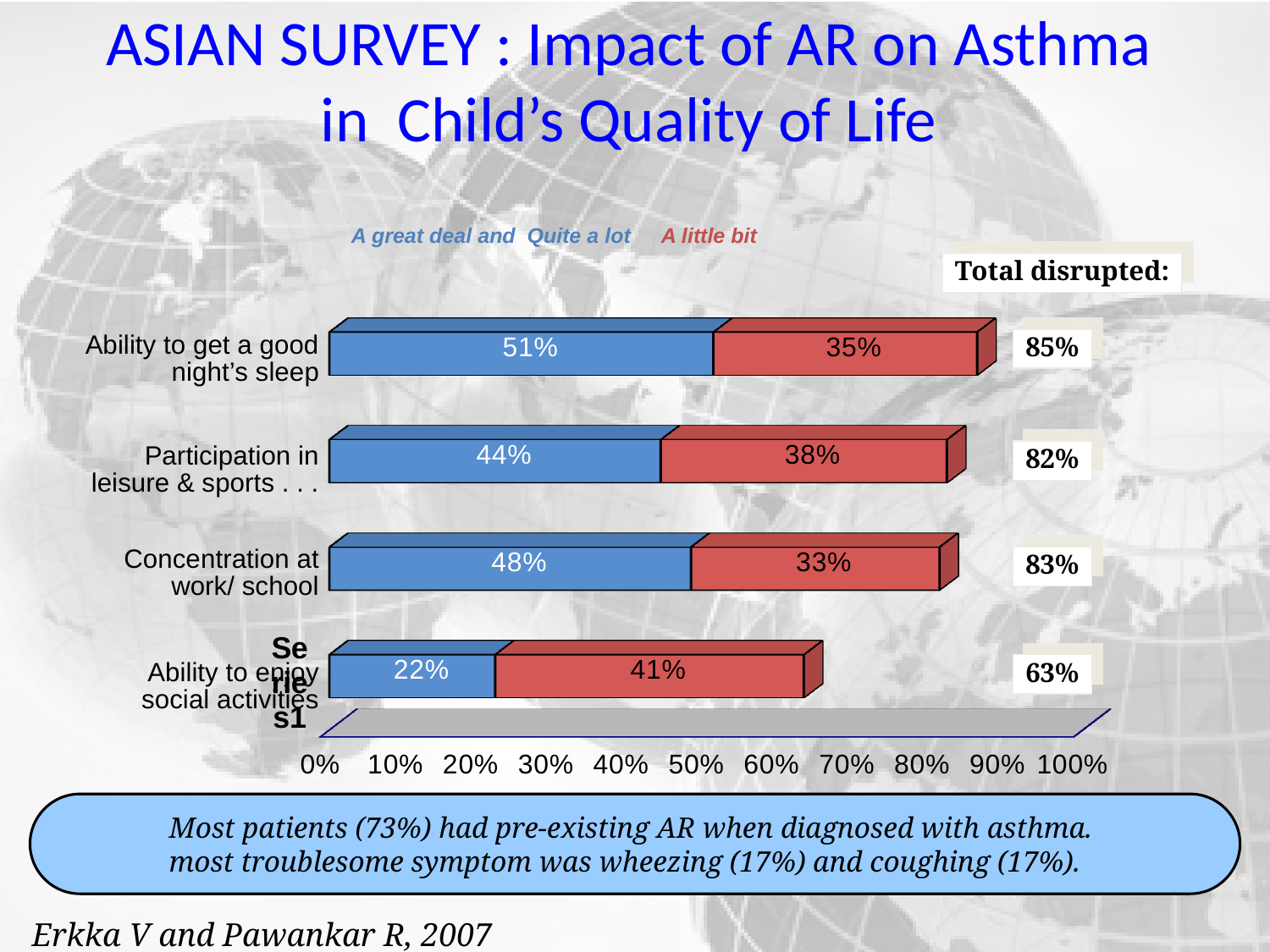
What 'Total disrupted' figure is shown for Ability to get a good night's sleep? 85% How many categories are plotted in the chart? 4 Which category has the lowest 'A great deal and Quite a lot' value? Ability to enjoy social activities What type of chart is shown on the slide? Stacked bar chart What is the 'A great deal and Quite a lot' value for Concentration at work/ school? 48% What percentage of respondents reported 'A great deal and Quite a lot' of impact on the ability to get a good night's sleep? 51% Which is larger for Concentration at work/ school: the 'A great deal and Quite a lot' value or the 'A little bit' value? A great deal and Quite a lot What is the total of the stacked bar for Participation in leisure & sports? 82% Which category has the highest 'A little bit' value? Ability to enjoy social activities What is the difference between the 'A great deal and Quite a lot' values for Ability to get a good night's sleep and Ability to enjoy social activities? 29% What is the 'A little bit' value for Participation in leisure & sports? 38% What is the 'A little bit' value for Ability to enjoy social activities? 41%